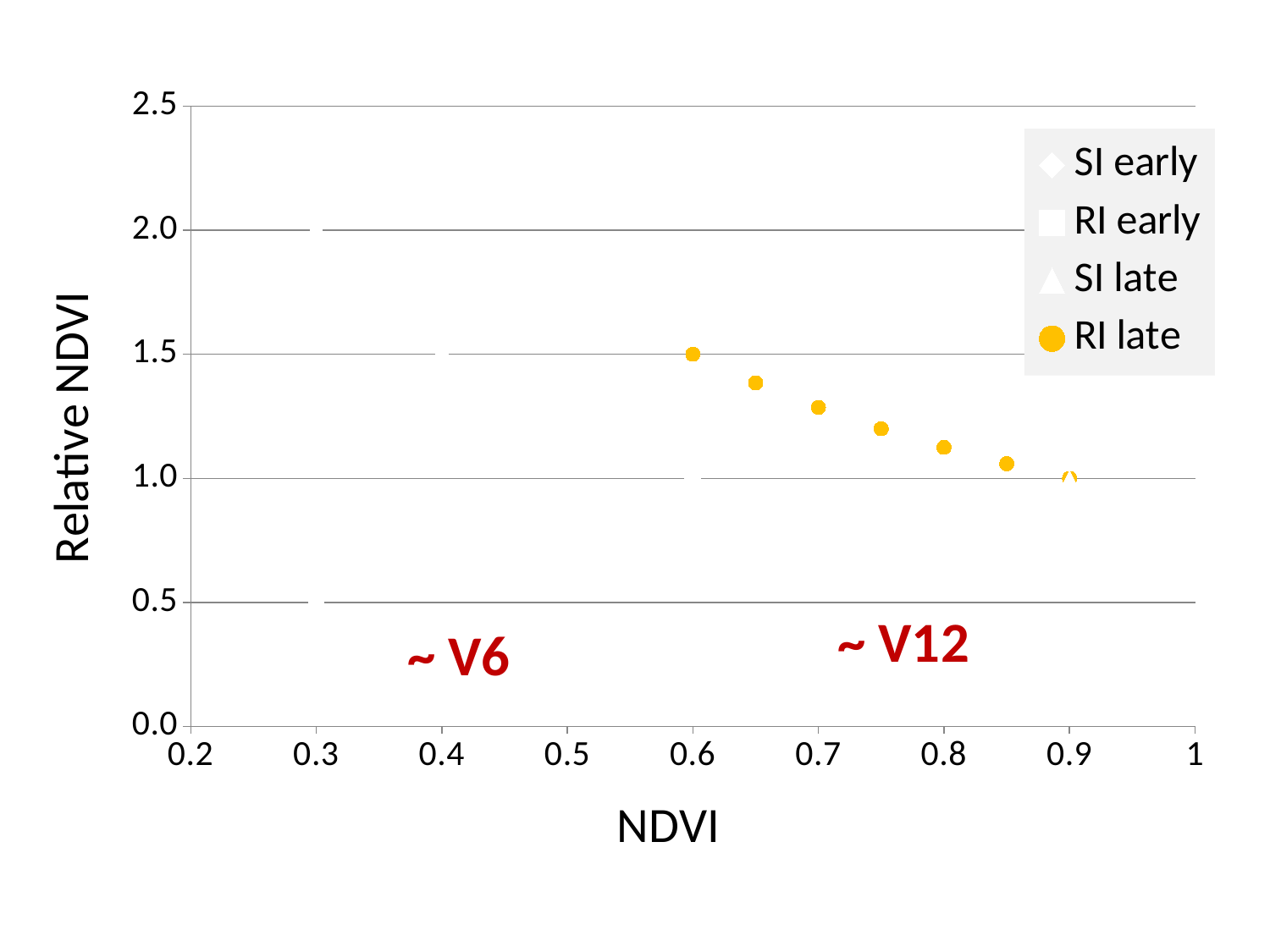
Which RI late point has the highest Relative NDVI value, the one at NDVI 0.6 or the one at NDVI 0.85? NDVI 0.6 What kind of chart is shown on the slide? scatter chart What is the label of the y axis? Relative NDVI Is the Relative NDVI value for RI late at NDVI 0.8 greater or less than 1.5? less What is the Relative NDVI value of the RI late point at NDVI 0.6? 1.5 Is the Relative NDVI value for RI late at NDVI 0.7 greater or less than 1.0? greater What is the Relative NDVI value of the RI late point at NDVI 0.9? 1.0 How many series does the legend list? 4 How many RI late points are plotted on the chart? 7 Which legend entry is shown with a yellow circle marker? RI late At which NDVI value does the RI late series reach its lowest Relative NDVI? 0.9 Do the RI late values rise or fall as NDVI increases along the x axis? fall